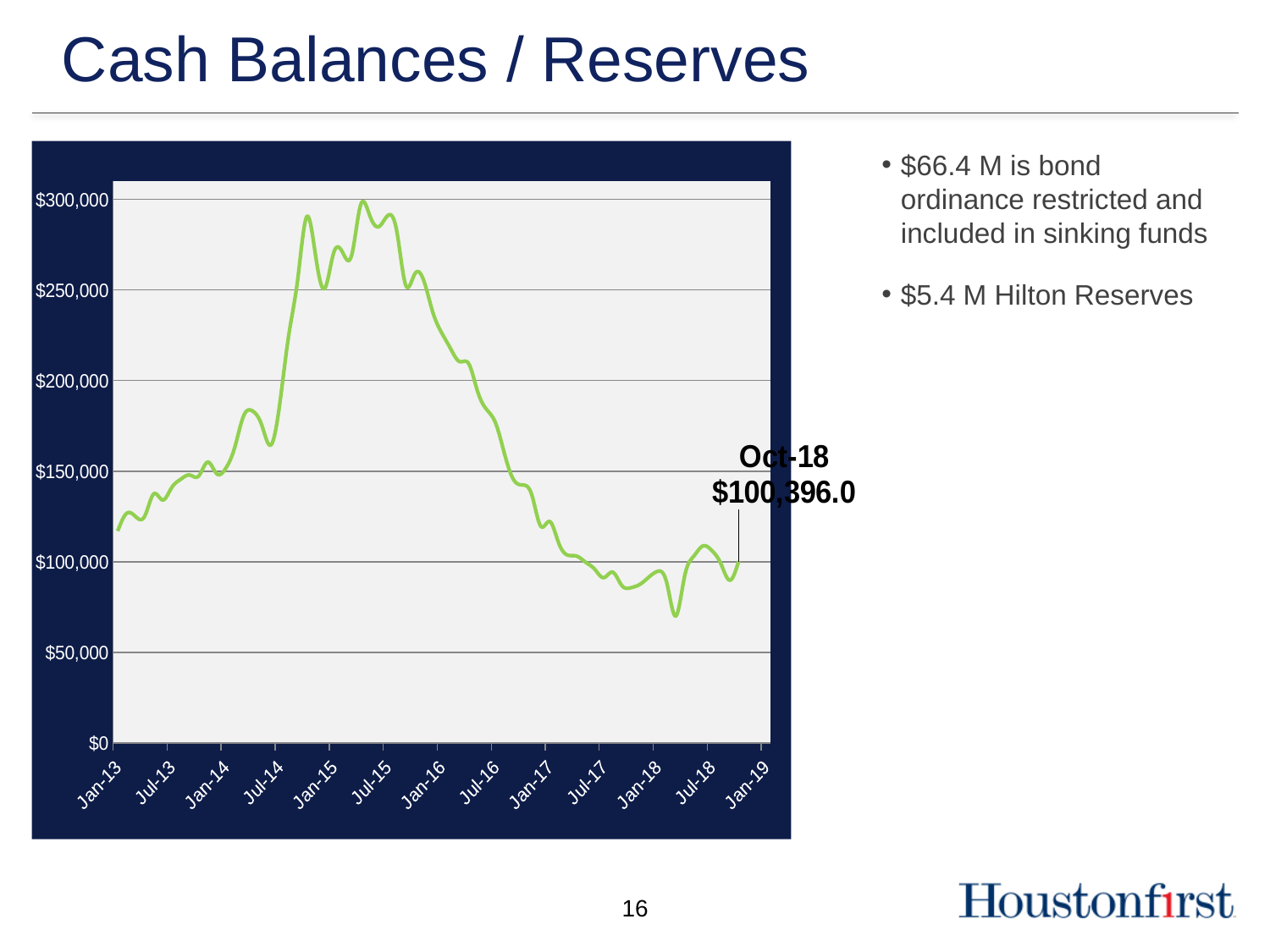
Which is larger, the value for Jul-16 or the value for Jul-17? Jul-16 What kind of chart is shown on the slide? line chart Do the values rise or fall along the x axis between Jul-15 and Jan-18? fall Is the value for Jan-17 greater or less than $150,000? less Is the value for Jan-16 greater or less than $200,000? greater Is the value for Jul-15 greater or less than $250,000? greater In which year does the line reach its highest point? 2015 What value is labelled on the chart for Oct-18? $100,396.0 In which year does the line reach its lowest point? 2018 How many tick labels are shown on the x axis? 13